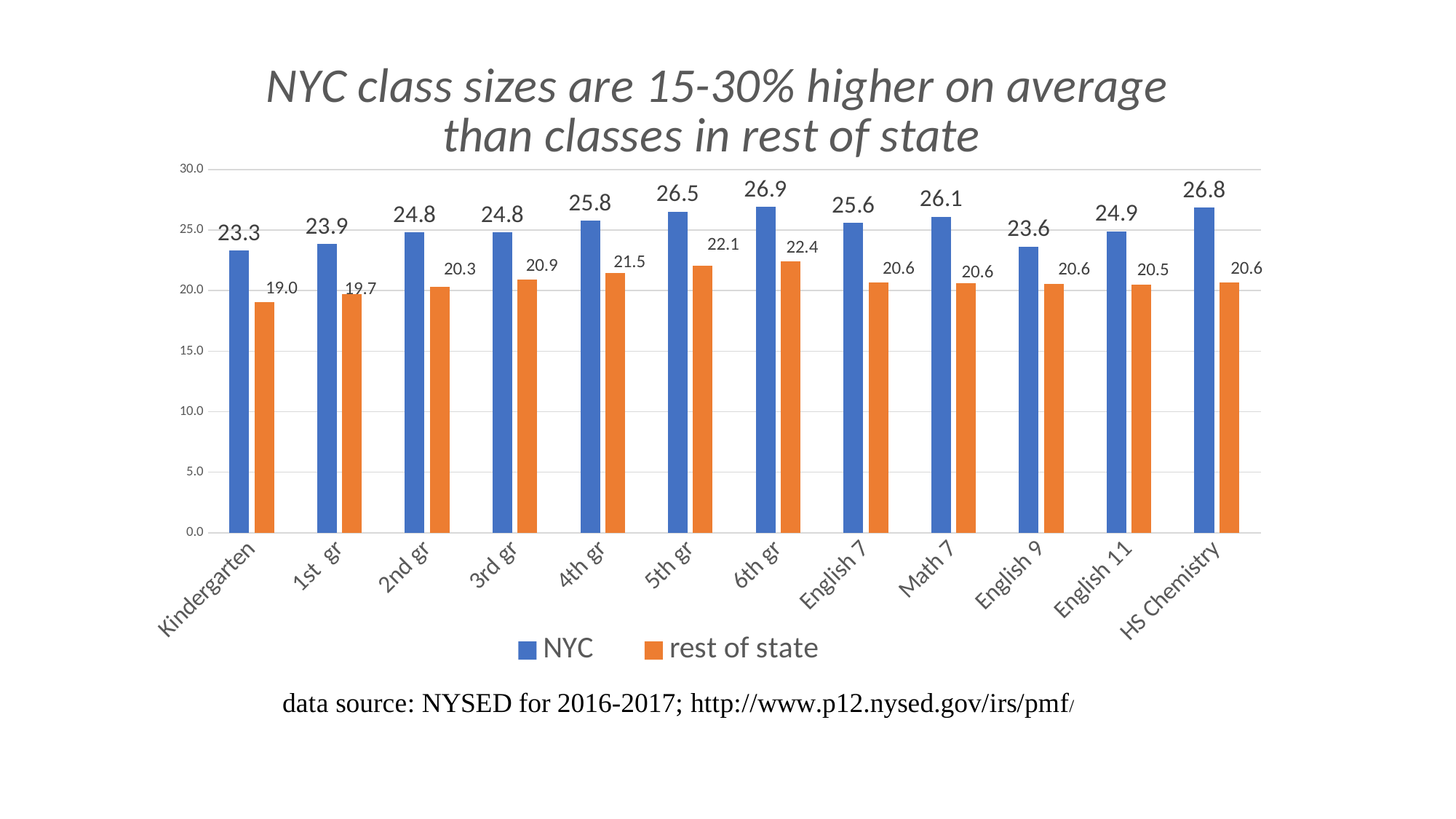
What kind of chart is shown on the slide? bar chart How many series does the legend list? 2 What is the rest of state class size for 5th gr? 22.1 What is the NYC class size for Kindergarten? 23.3 Which category has the highest NYC class size? 6th gr How many categories are shown on the x axis? 12 Is the rest of state class size for 4th gr greater or less than 20.0? greater Which is larger, the NYC class size for Math 7 or the NYC class size for English 9? Math 7 Which category has the lowest rest of state class size? Kindergarten What is the difference between the NYC and rest of state class sizes for 6th gr? 4.5 Which series is shown in orange? rest of state What is the NYC class size for HS Chemistry? 26.8